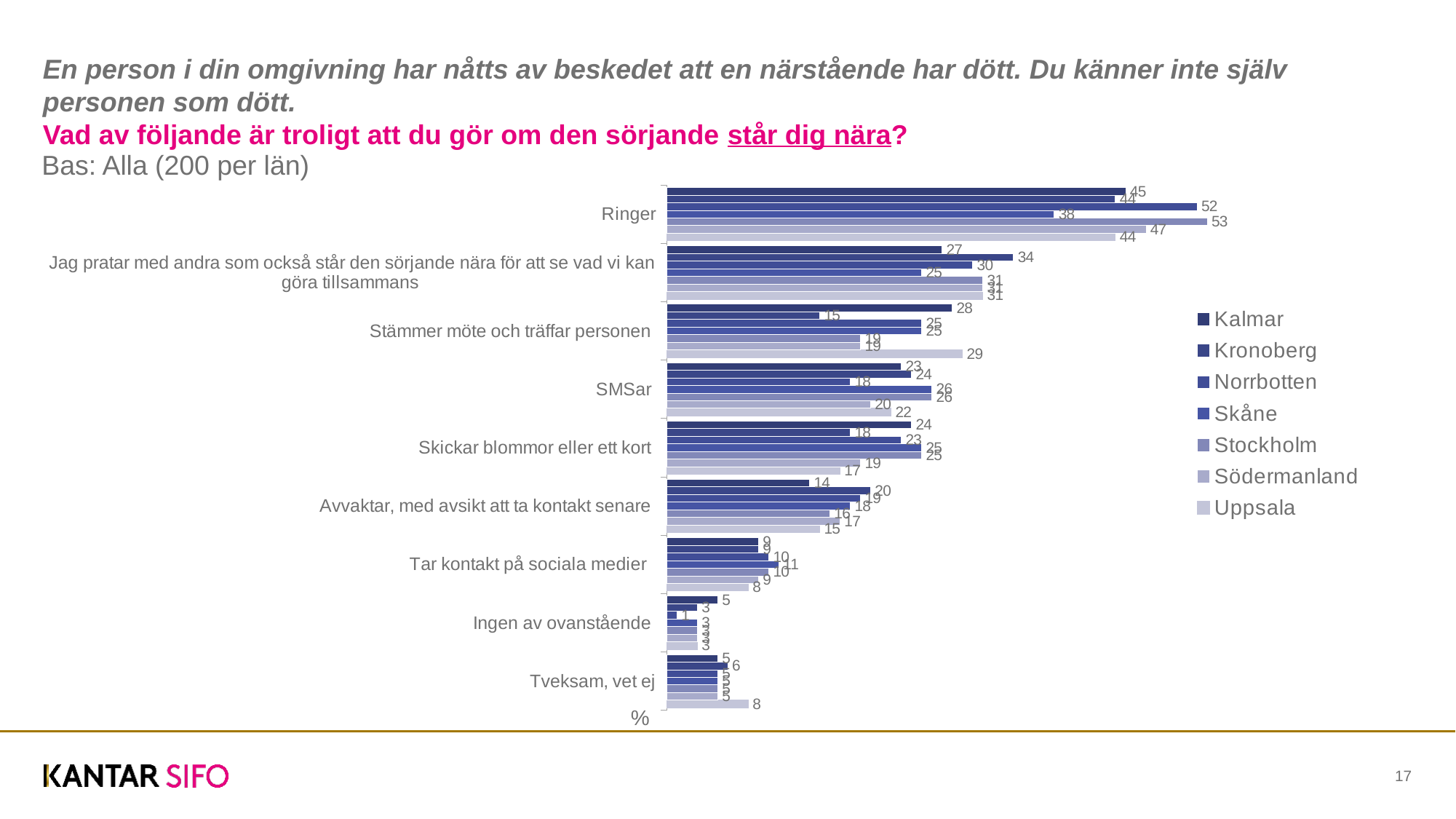
How many categories (response options) are shown on the chart? 9 What is the value for Stockholm in the 'Ringer' category? 53 What is the value for Uppsala in the 'Stämmer möte och träffar personen' category? 29 What is the difference between Stockholm and Skåne in the 'Ringer' category? 15 What is the value for Kalmar in the 'Avvaktar, med avsikt att ta kontakt senare' category? 14 What kind of chart is shown on the slide? bar chart Which county has the highest value in the 'Ringer' category? Stockholm What is the value for Uppsala in the 'Tveksam, vet ej' category? 8 Which county has the lowest value in the 'Stämmer möte och träffar personen' category? Kronoberg What is the value for Kronoberg in the category 'Jag pratar med andra som också står den sörjande nära för att se vad vi kan göra tillsammans'? 34 In the 'Stämmer möte och träffar personen' category, which is larger: Kalmar or Kronoberg? Kalmar How many series does the legend list? 7